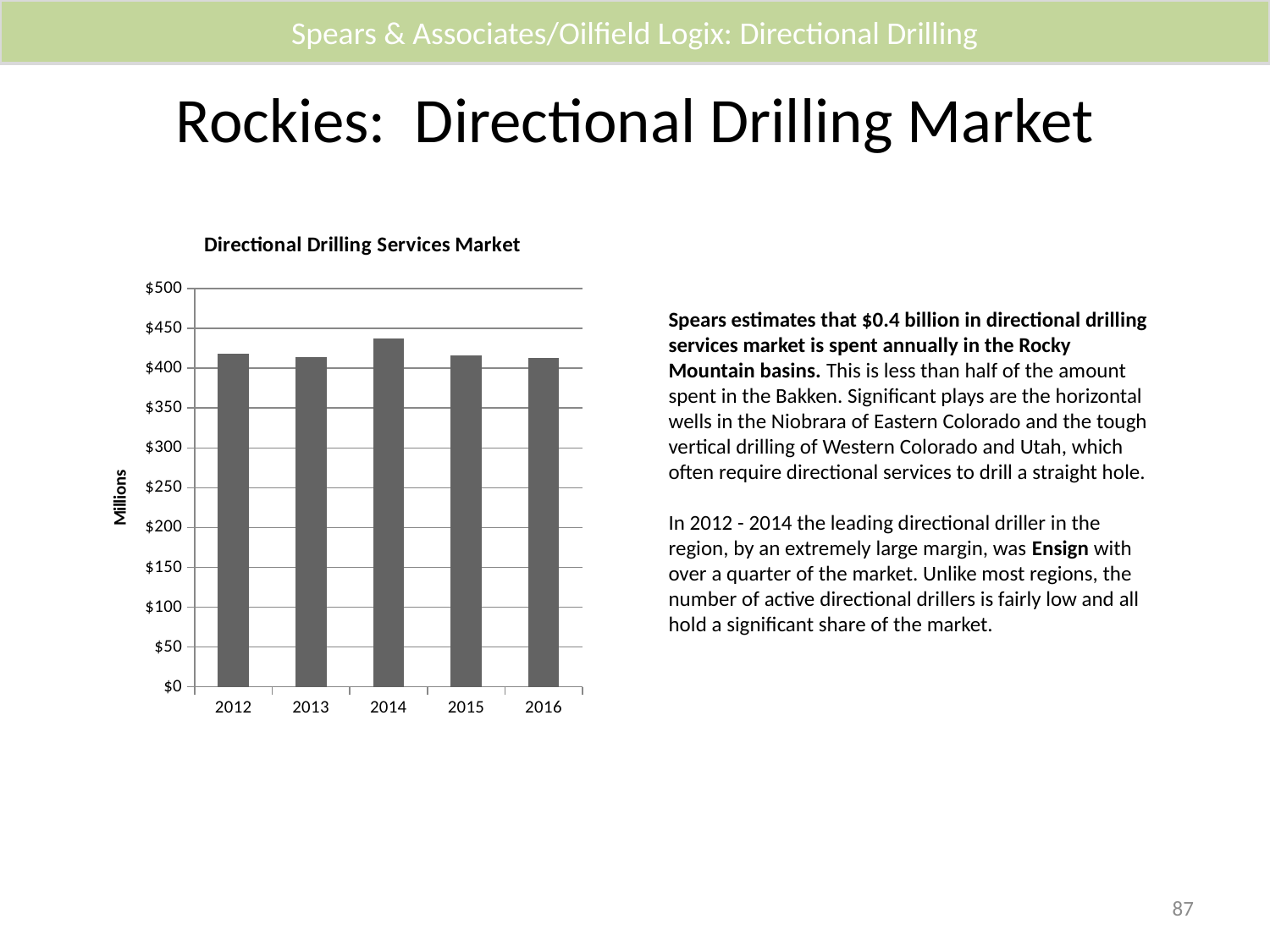
Is the value for 2014 greater or less than $450? less What is the label on the vertical axis of the chart? Millions Which is larger, the value for 2013 or the value for 2014? 2014 What kind of chart is shown on the slide? bar chart Is the value for 2012 greater or less than $400? greater Which year has the highest value in the chart? 2014 Which is larger, the value for 2014 or the value for 2015? 2014 Is the value for 2016 greater or less than $450? less What is the title of the chart? Directional Drilling Services Market Does the value rise or fall from 2013 to 2014? rise How many years are shown on the x axis of the chart? 5